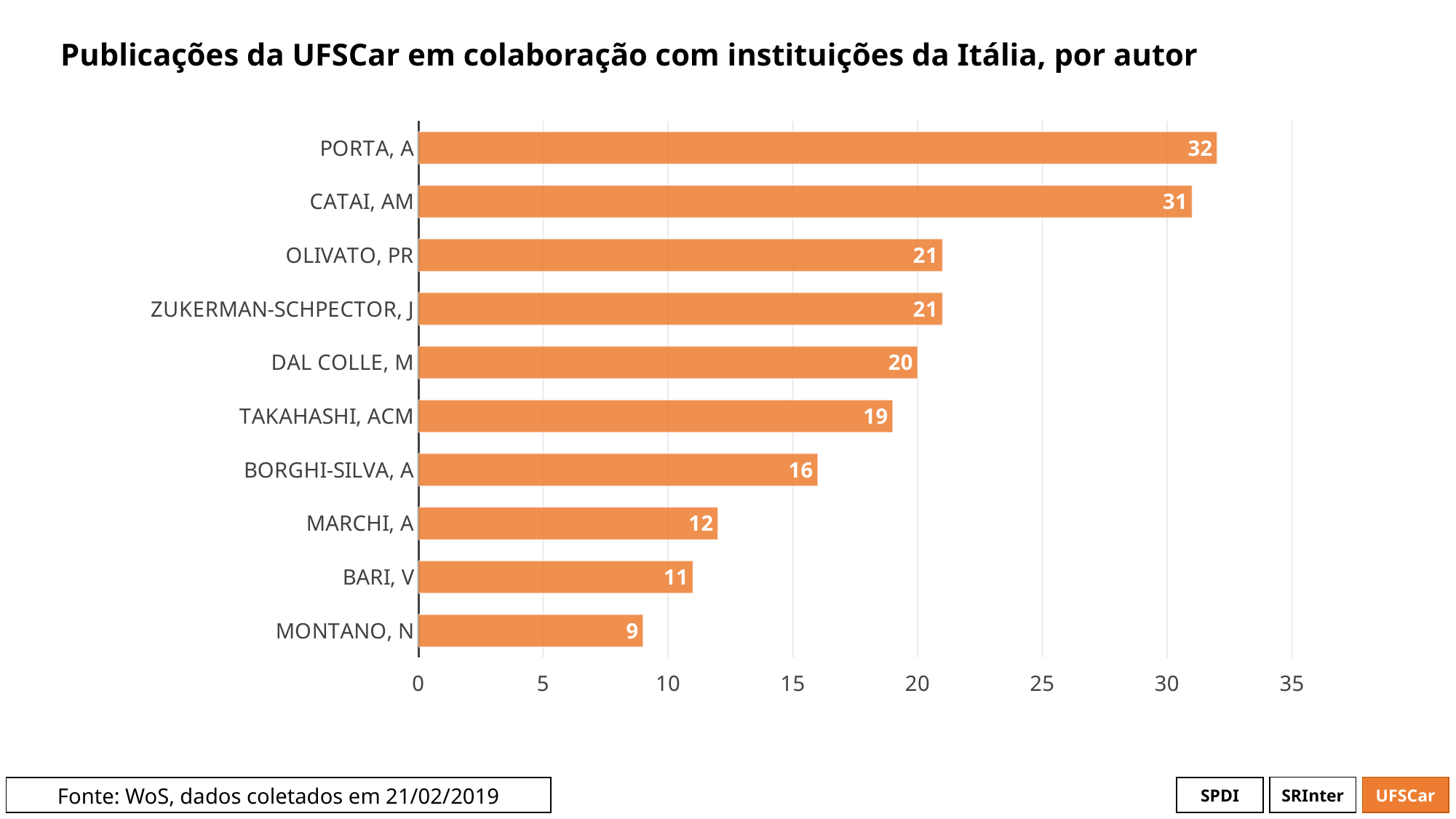
What is the value for TAKAHASHI, ACM? 19 Which author has the lowest number of publications? MONTANO, N What is the difference between the values for DAL COLLE, M and MARCHI, A? 8 Which author has the highest number of publications? PORTA, A What is the value for MONTANO, N? 9 What kind of chart is shown on the slide? bar chart What is the title of the chart? Publicações da UFSCar em colaboração com instituições da Itália, por autor How many publications does PORTA, A have? 32 What is the difference between the values for PORTA, A and CATAI, AM? 1 Is the value for OLIVATO, PR greater or less than 20? greater Which is larger, the value for BORGHI-SILVA, A or the value for BARI, V? BORGHI-SILVA, A How many authors are shown in the chart? 10